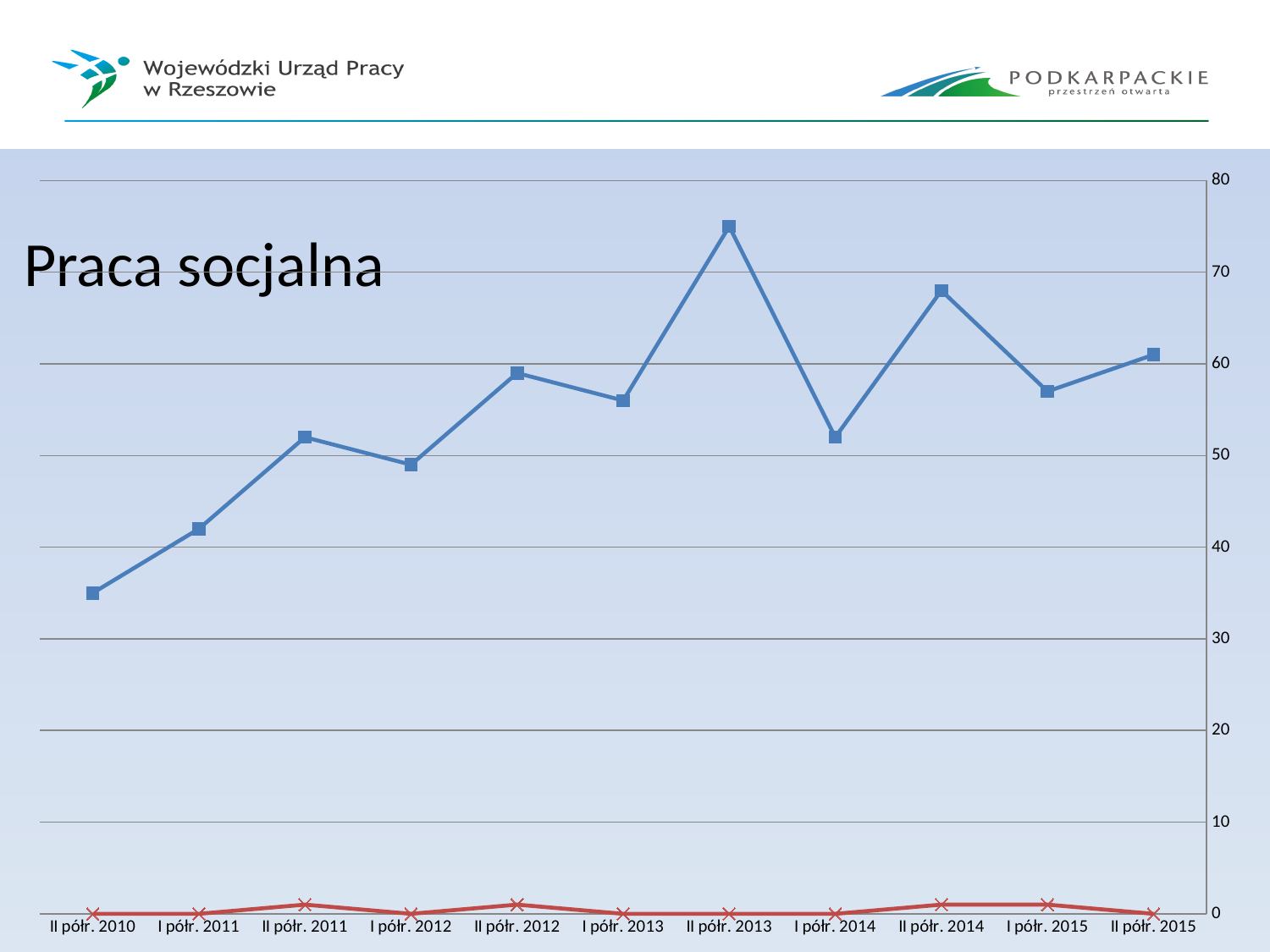
In which period does the blue line reach its highest value? II półr. 2013 What is the title of the chart? Praca socjalna Is the value of the blue line for II półr. 2010 greater or less than 40? less In which period does the blue line have its lowest value? II półr. 2010 How many periods are shown along the x axis of the chart? 11 What kind of chart is shown on the slide? line chart Does the blue line rise or fall from II półr. 2010 to II półr. 2011? rise Is the value of the blue line for I półr. 2014 greater or less than 60? less Is the value of the blue line for II półr. 2014 greater or less than 60? greater Which has the larger value on the blue line: II półr. 2014 or I półr. 2015? II półr. 2014 Which has the larger value on the blue line: II półr. 2013 or I półr. 2014? II półr. 2013